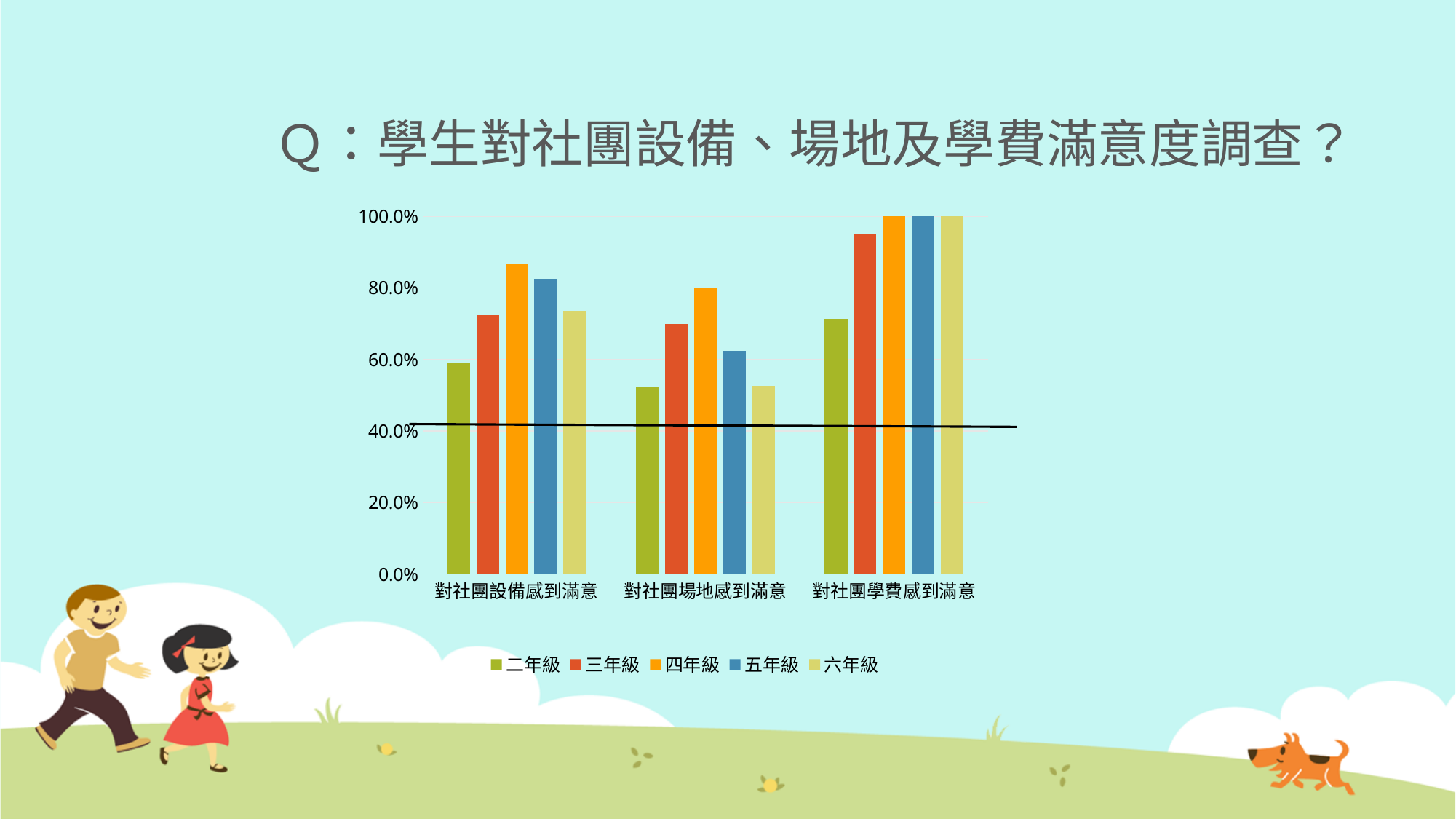
What is the value for 五年級 in the 對社團學費感到滿意 category? 100.0% Is the value for 三年級 in 對社團學費感到滿意 greater or less than 80.0%? greater How many series does the chart's legend list? 5 Is the value for 二年級 in 對社團場地感到滿意 greater or less than 60.0%? less Which grade has the lowest value in the 對社團學費感到滿意 category? 二年級 How many categories are shown on the x axis of the chart? 3 What kind of chart is shown on the slide? bar chart What is the value for 四年級 in the 對社團學費感到滿意 category? 100.0% Is the value for 四年級 in 對社團設備感到滿意 greater or less than 80.0%? greater Which grade has the lowest value in the 對社團設備感到滿意 category? 二年級 Which grade has the highest value in the 對社團場地感到滿意 category? 四年級 For 五年級, which is larger: the value for 對社團設備感到滿意 or the value for 對社團場地感到滿意? 對社團設備感到滿意